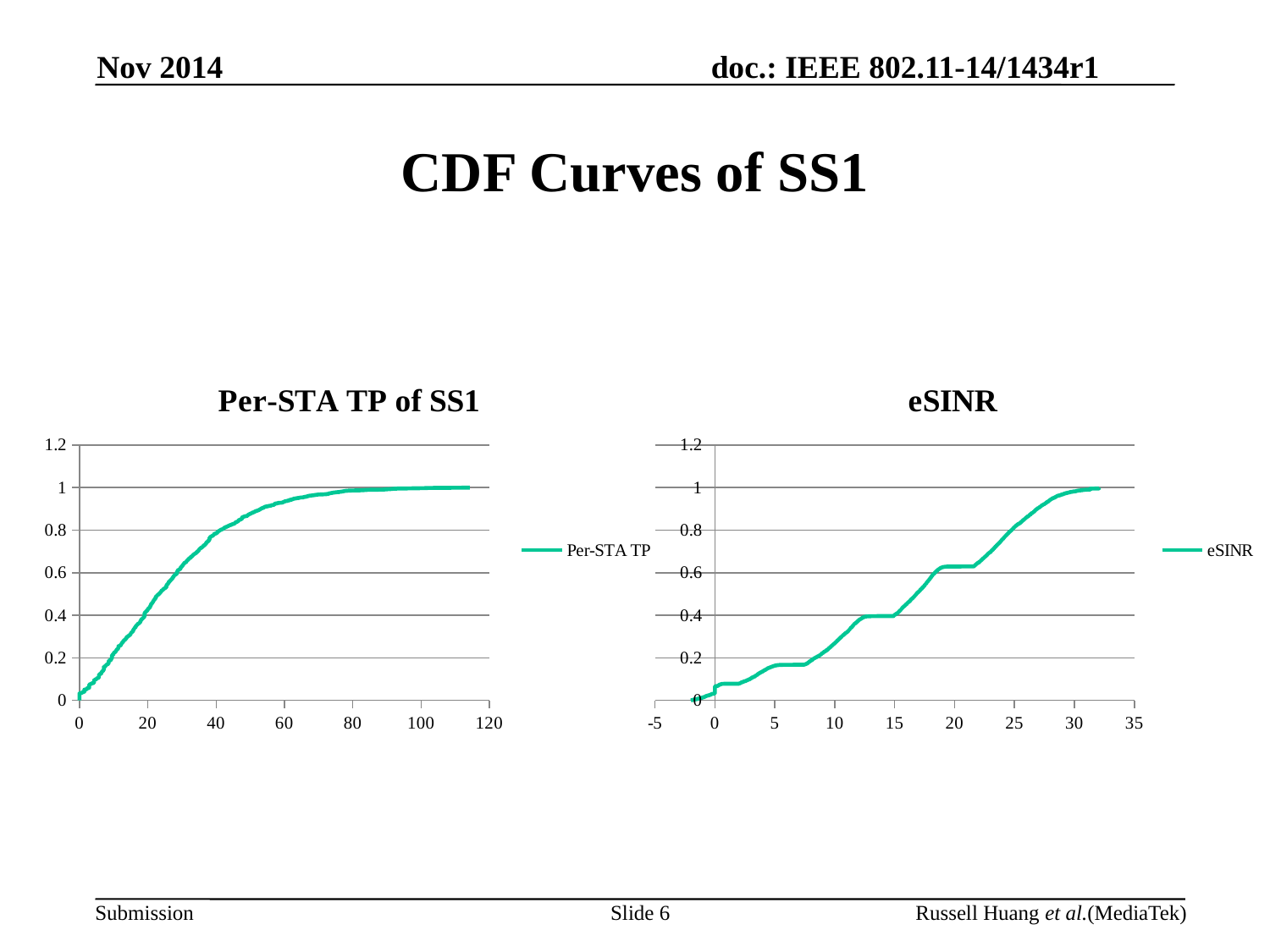
What kind of chart is the 'Per-STA TP of SS1' chart? line chart In the 'eSINR' chart, how many series does the legend list? 1 In the 'eSINR' chart, is the value at x = 30 greater or less than 0.8? greater In the 'eSINR' chart, do the values rise or fall as the x axis increases? rise In the 'Per-STA TP of SS1' chart, is the value at x = 60 greater or less than 0.8? greater In the 'eSINR' chart, is the value at x = 10 greater or less than 0.4? less What kind of chart is the 'eSINR' chart? line chart In the 'Per-STA TP of SS1' chart, how many series does the legend list? 1 In the 'Per-STA TP of SS1' chart, do the values rise or fall as the x axis increases? rise What is the title of the chart on the right? eSINR What is the legend entry of the chart on the left? Per-STA TP